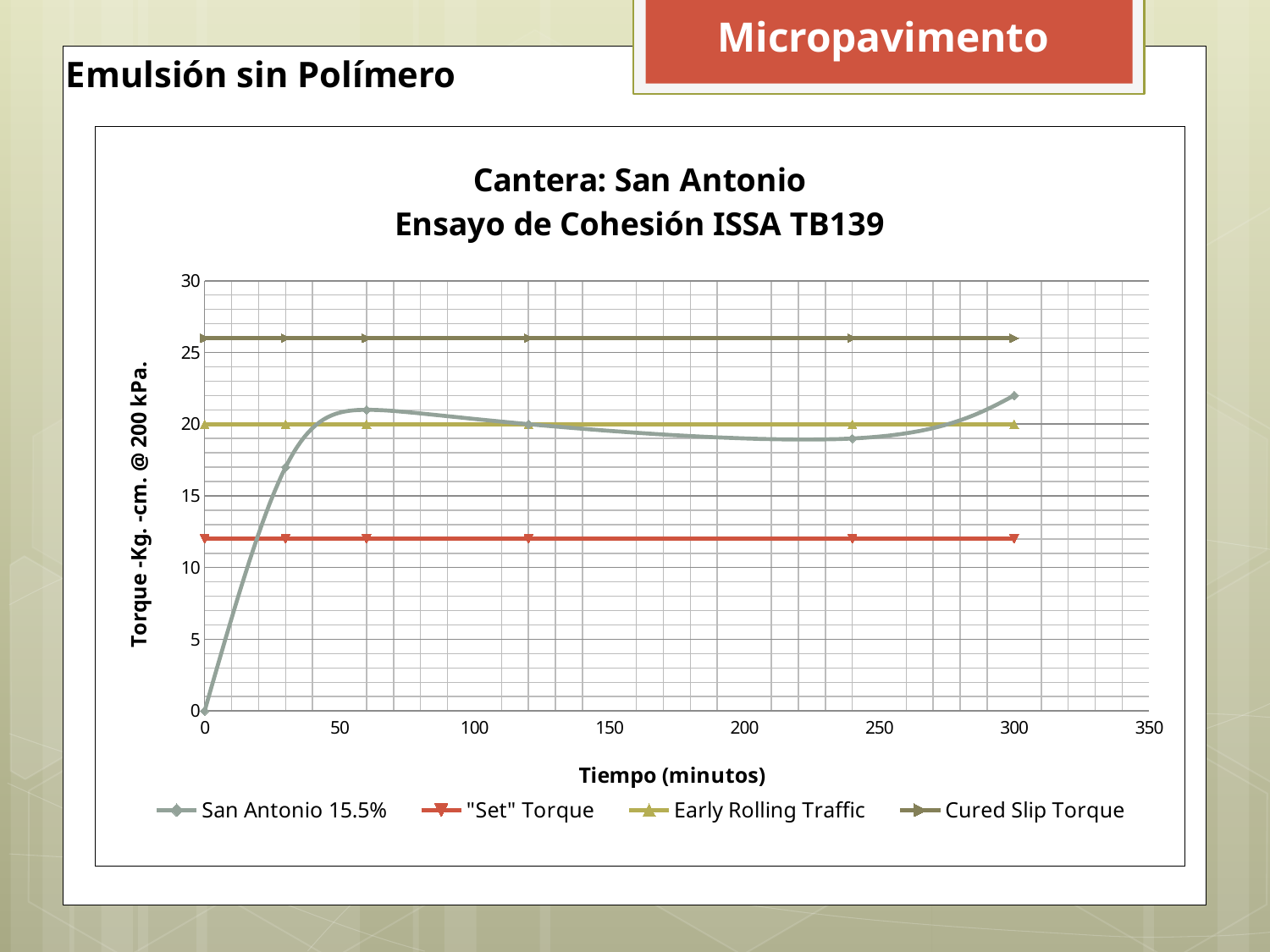
What is the torque value of the San Antonio 15.5% series at 0 minutes? 0 Does the San Antonio 15.5% series rise or fall between 0 and 60 minutes? rise What is the title of the chart? Cantera: San Antonio Ensayo de Cohesión ISSA TB139 Is the value of the Cured Slip Torque line greater or less than 25? greater What kind of chart is shown on the slide? line chart Is the value of the San Antonio 15.5% series at 30 minutes greater or less than 15? greater How many series does the legend list? 4 What constant torque value does the Early Rolling Traffic line sit at? 20 At 300 minutes, which is larger: the San Antonio 15.5% value or the "Set" Torque value? San Antonio 15.5% What is the label of the x axis? Tiempo (minutos) Is the value of the "Set" Torque line greater or less than 15? less Which series has the highest torque values across the chart? Cured Slip Torque